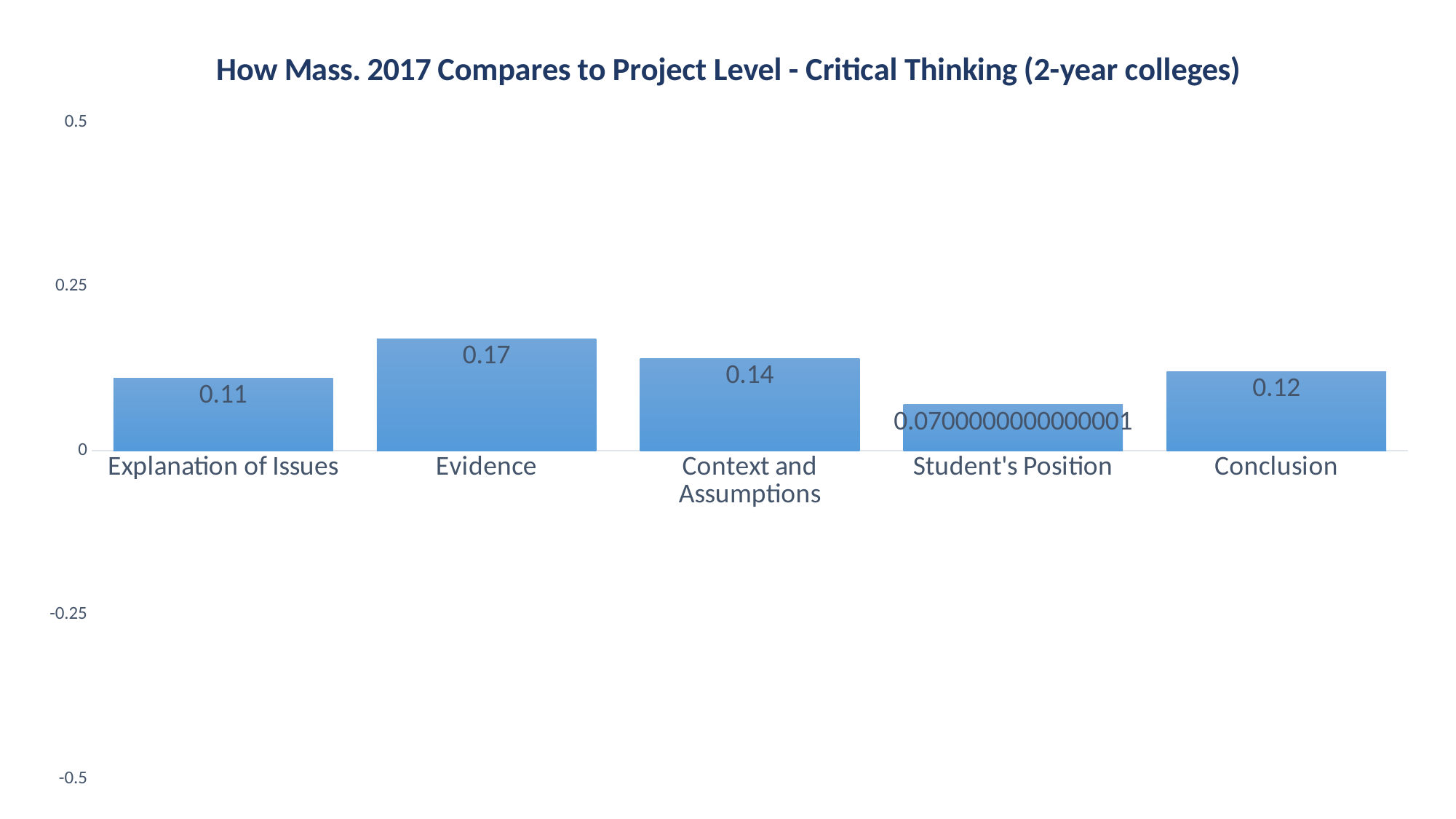
Which category has the highest value? Evidence What is the difference between the values for Evidence and Context and Assumptions? 0.03 Which is larger, the value for Explanation of Issues or the value for Conclusion? Conclusion How many categories are shown on the chart? 5 What is the title of the chart? How Mass. 2017 Compares to Project Level - Critical Thinking (2-year colleges) Is the value for Evidence greater or less than 0.25? less What kind of chart is shown on the slide? bar chart What is the value for Explanation of Issues? 0.11 What is the value for Conclusion? 0.12 Which category has the lowest value? Student's Position What is the value for Evidence? 0.17 What is the value for Context and Assumptions? 0.14